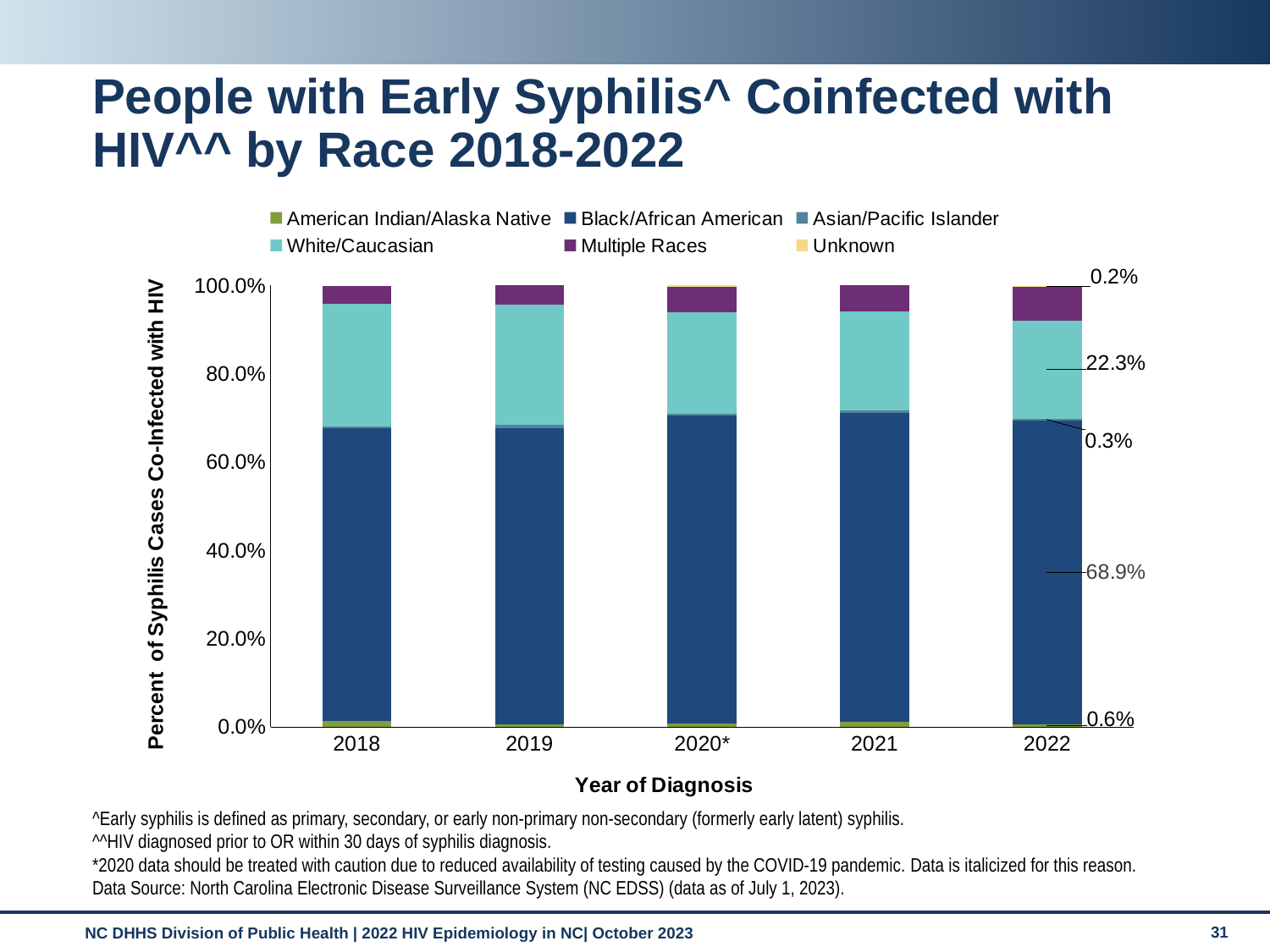
What is the difference between the Black/African American and White/Caucasian values in 2022? 46.6% What is the value for Asian/Pacific Islander in 2022? 0.3% How many series does the legend list? 6 What type of chart is shown on the slide? stacked bar chart What is the value for Black/African American in 2022? 68.9% Is the value for Black/African American in 2018 greater or less than 60.0%? greater What is the value for White/Caucasian in 2022? 22.3% What is the title of the x axis? Year of Diagnosis Which race group has the largest share in 2022? Black/African American What is the value for Unknown in 2022? 0.2% What is the value for American Indian/Alaska Native in 2022? 0.6% How many years are shown on the x axis? 5